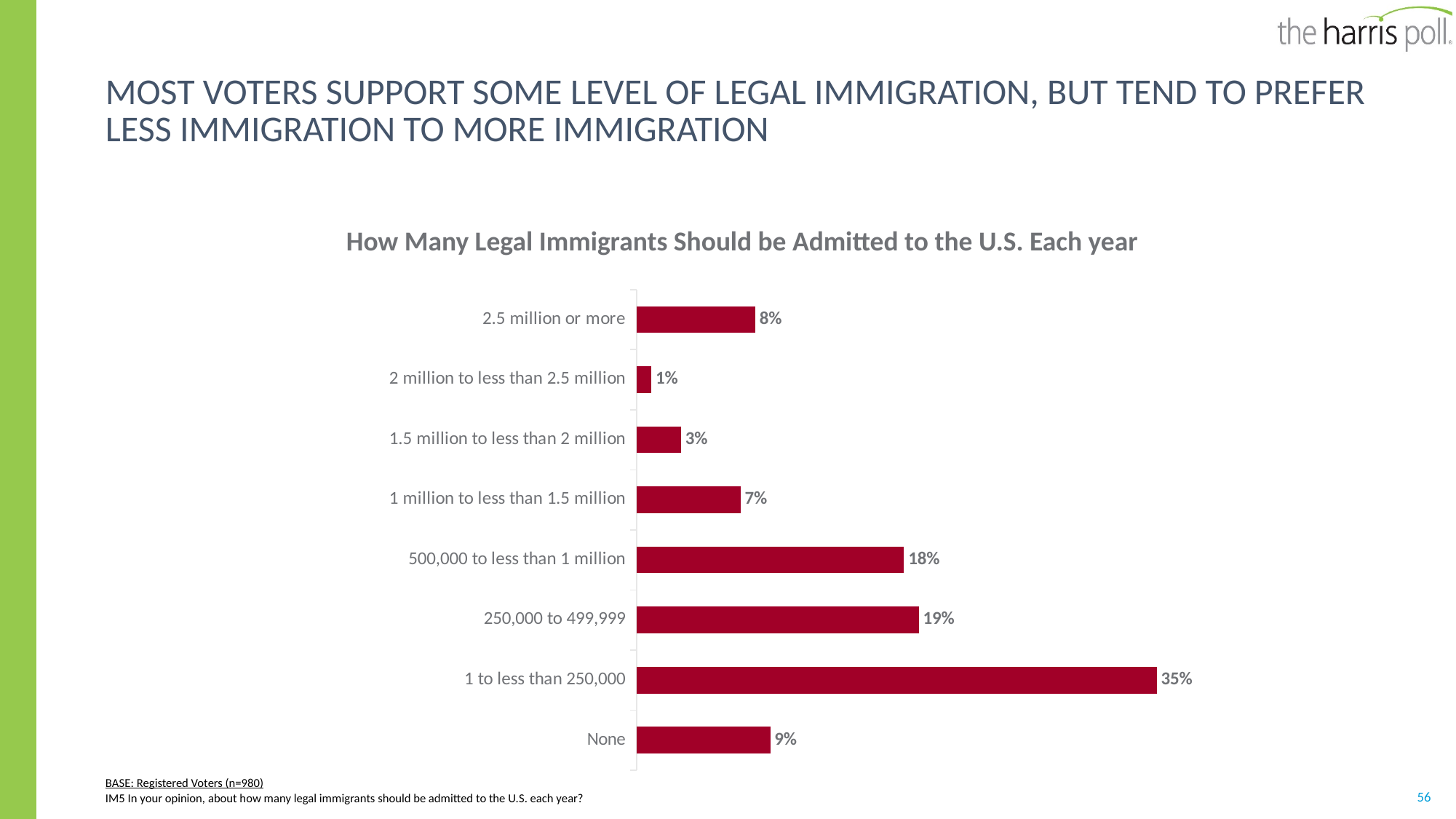
What is the difference between the values for '1 to less than 250,000' and '250,000 to 499,999'? 16% What kind of chart is shown on the slide? Bar chart Which category has the highest value? 1 to less than 250,000 How many categories are shown in the chart? 8 What is the title of the chart? How Many Legal Immigrants Should be Admitted to the U.S. Each year Which is larger: the value for '2.5 million or more' or the value for 'None'? None What percentage of voters chose 'None'? 9% What is the difference between the values for '1.5 million to less than 2 million' and '1 million to less than 1.5 million'? 4% What is the value for the '2 million to less than 2.5 million' category? 1% Which category has the lowest value? 2 million to less than 2.5 million What is the value for '500,000 to less than 1 million'? 18% What percentage of voters said 1 to less than 250,000 legal immigrants should be admitted each year? 35%